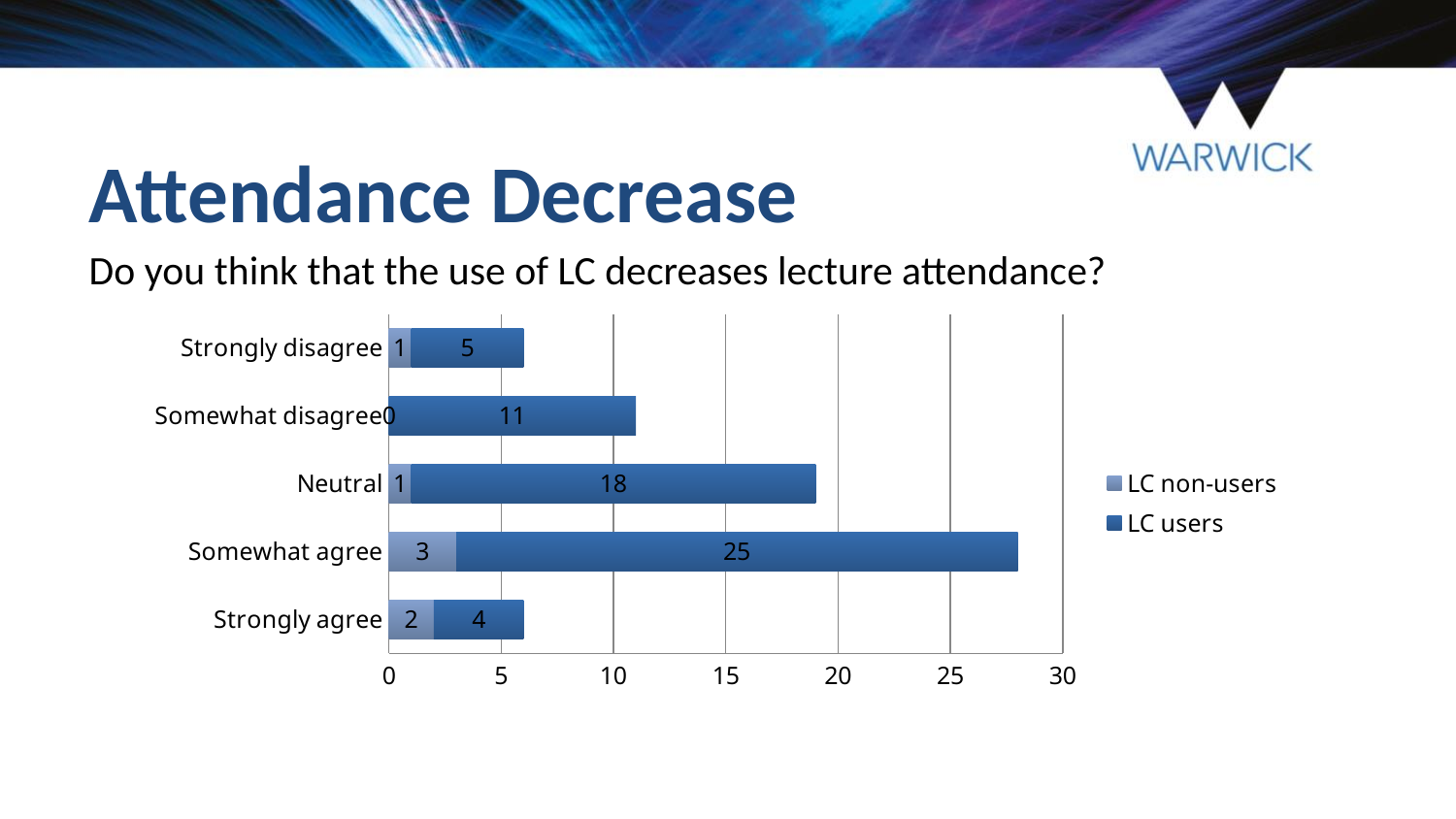
Which is larger for LC users: Somewhat disagree or Strongly disagree? Somewhat disagree What is the value for LC non-users in the Somewhat disagree category? 0 What is the value for LC users in the Somewhat agree category? 25 What is the value for LC users in the Neutral category? 18 Which category has the lowest value for LC users? Strongly agree How many categories are shown on the chart? 5 How many series does the legend list? 2 What is the value for LC non-users in the Strongly agree category? 2 What is the total of the stacked bar for Somewhat agree? 28 What is the difference between the LC users values for Somewhat agree and Neutral? 7 Which category has the highest value for LC users? Somewhat agree What kind of chart is shown on the slide? Stacked bar chart